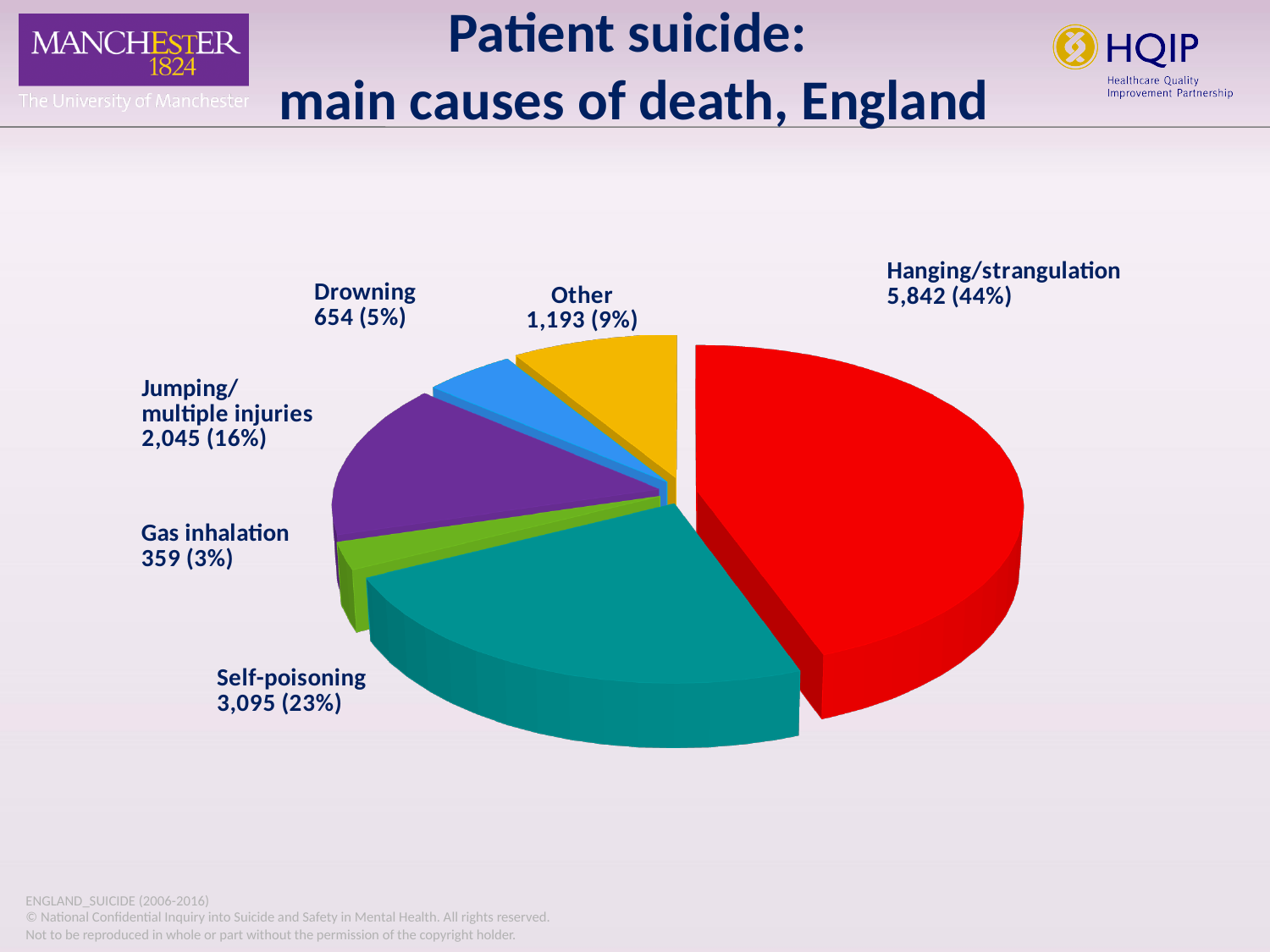
Which cause of death has the smallest slice? Gas inhalation What colour is the Self-poisoning slice? Teal What is the number of deaths for Gas inhalation? 359 What is the difference in deaths between Hanging/strangulation and Self-poisoning? 2,747 What kind of chart is shown on the slide? Pie chart Which cause of death has the largest slice? Hanging/strangulation How many slices does the pie chart have? 6 What is the number of deaths for Hanging/strangulation? 5,842 Which has more deaths, Other or Drowning? Other What percentage share does Drowning have? 5% What percentage share does Jumping/multiple injuries have? 16% What is the number of deaths for Self-poisoning? 3,095